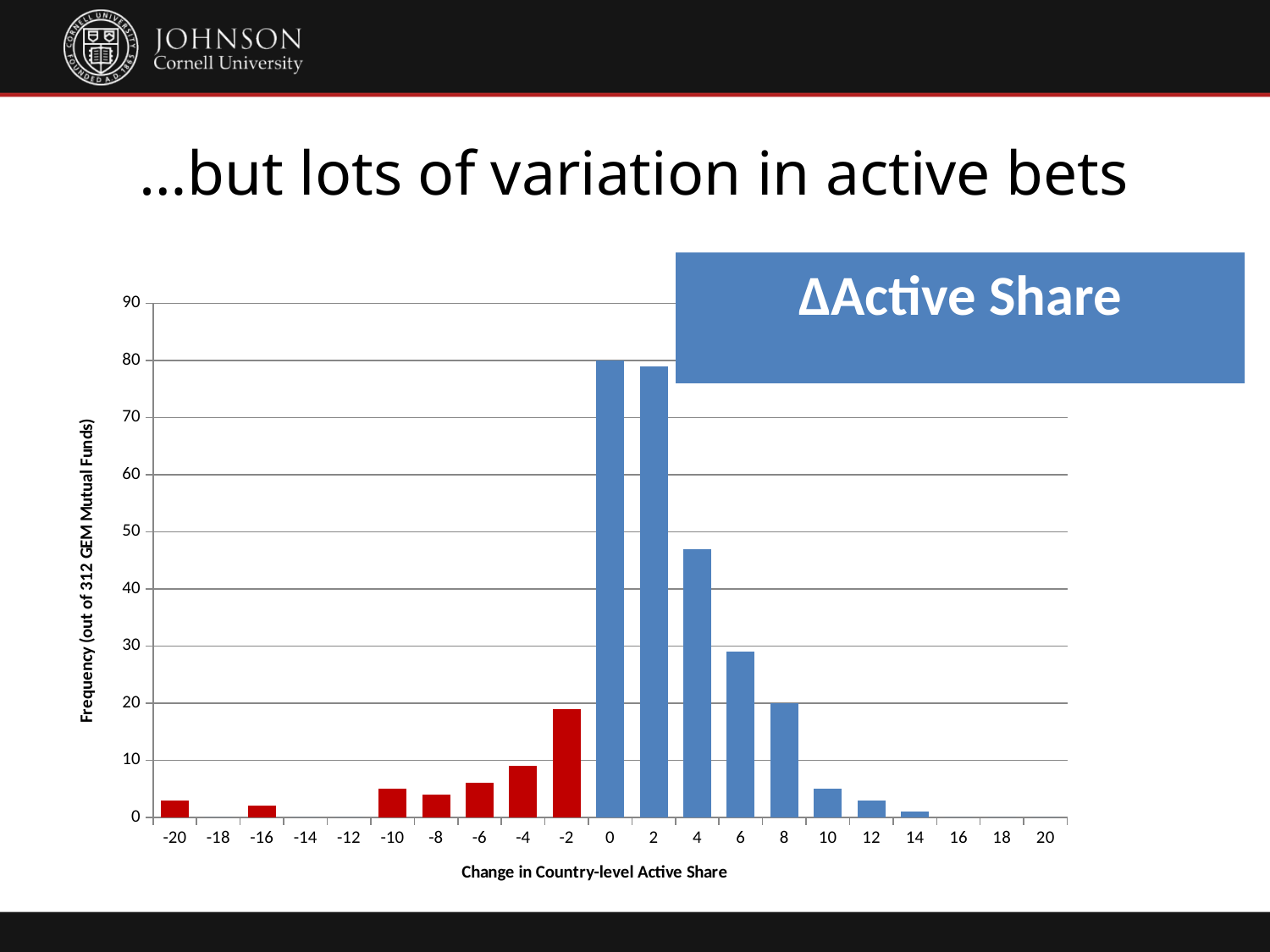
Is the frequency for a change of 2 greater or less than 70? greater Is the frequency for a change of 4 greater or less than 50? less Which has the higher frequency: a change of 0 or a change of 4? 0 Is the frequency for a change of -2 greater or less than 10? greater Do the frequencies rise or fall as the change in active share increases from 0 to 14? fall What is the title of the x axis of the chart? Change in Country-level Active Share How many red bars are shown in the chart? 7 Which has the higher frequency: a change of 6 or a change of 8? 6 What is the frequency for a change in country-level active share of 0? 80 What is the frequency for a change in country-level active share of 8? 20 What kind of chart is shown on the slide? bar chart